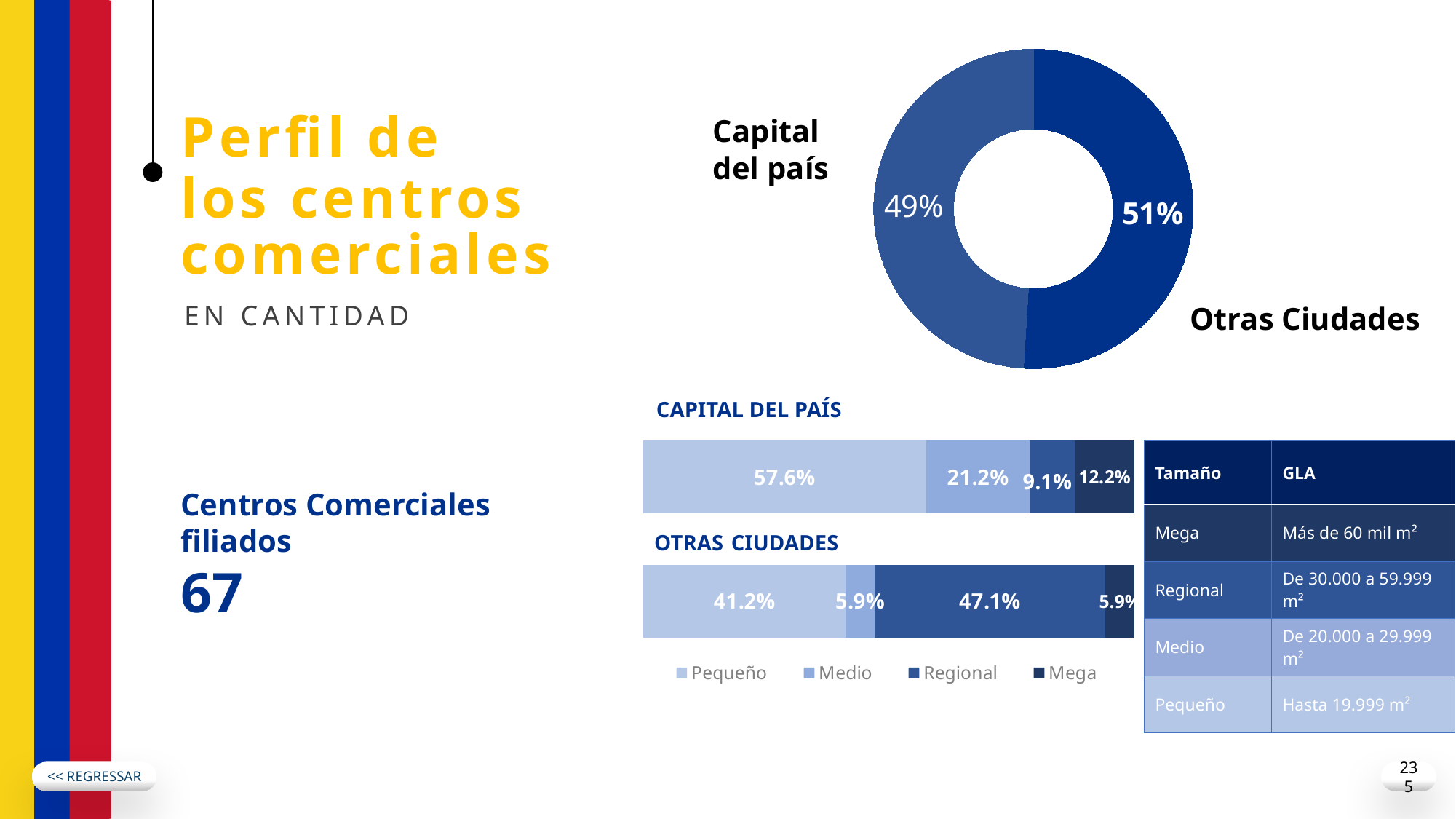
In the Capital del País stacked bar, which is larger, Medio or Mega? Medio In the Capital del País stacked bar, which segment is the smallest? Regional What kind of chart shows the split between Capital del país and Otras Ciudades? Donut chart In the Capital del País stacked bar, what is the value for Mega? 12.2% In the Otras Ciudades stacked bar, which segment is the largest? Regional How many series does the legend of the stacked bar charts list? 4 In the Otras Ciudades stacked bar, what is the value for Regional? 47.1% In the donut chart, what share is shown for Otras Ciudades? 51% In the donut chart, what share is shown for Capital del país? 49% In the donut chart, which segment is larger, Capital del país or Otras Ciudades? Otras Ciudades What is the difference between the Pequeño values in the Capital del País bar and the Otras Ciudades bar? 16.4% In the Capital del País stacked bar, what is the value for Pequeño? 57.6%